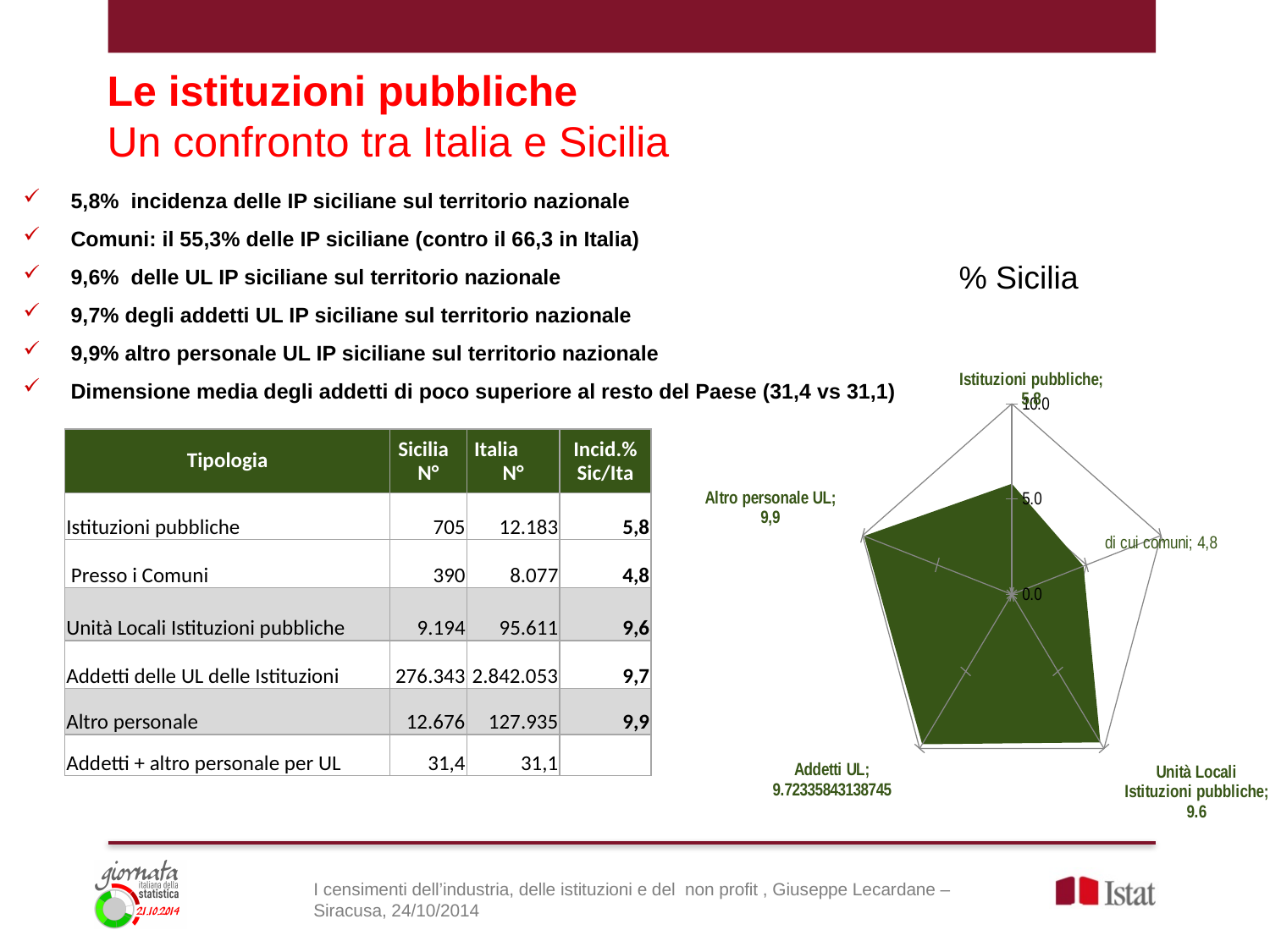
In the radar chart, what is the value for Addetti UL? 9.72335843138745 What kind of chart is shown on the right of the slide? Radar chart Which category has the highest value in the radar chart? Altro personale UL In the radar chart, what is the difference between the value for Altro personale UL and the value for di cui comuni? 5,1 Which category has the lowest value in the radar chart? di cui comuni What is the title of the radar chart? % Sicilia In the radar chart, what is the value for Altro personale UL? 9,9 How many categories (axes) does the radar chart have? 5 In the radar chart, what is the value for di cui comuni? 4,8 In the radar chart, what is the value for Unità Locali Istituzioni pubbliche? 9.6 What colour is the filled area of the radar chart? Dark green In the radar chart, is the value for di cui comuni greater or less than 5.0? less